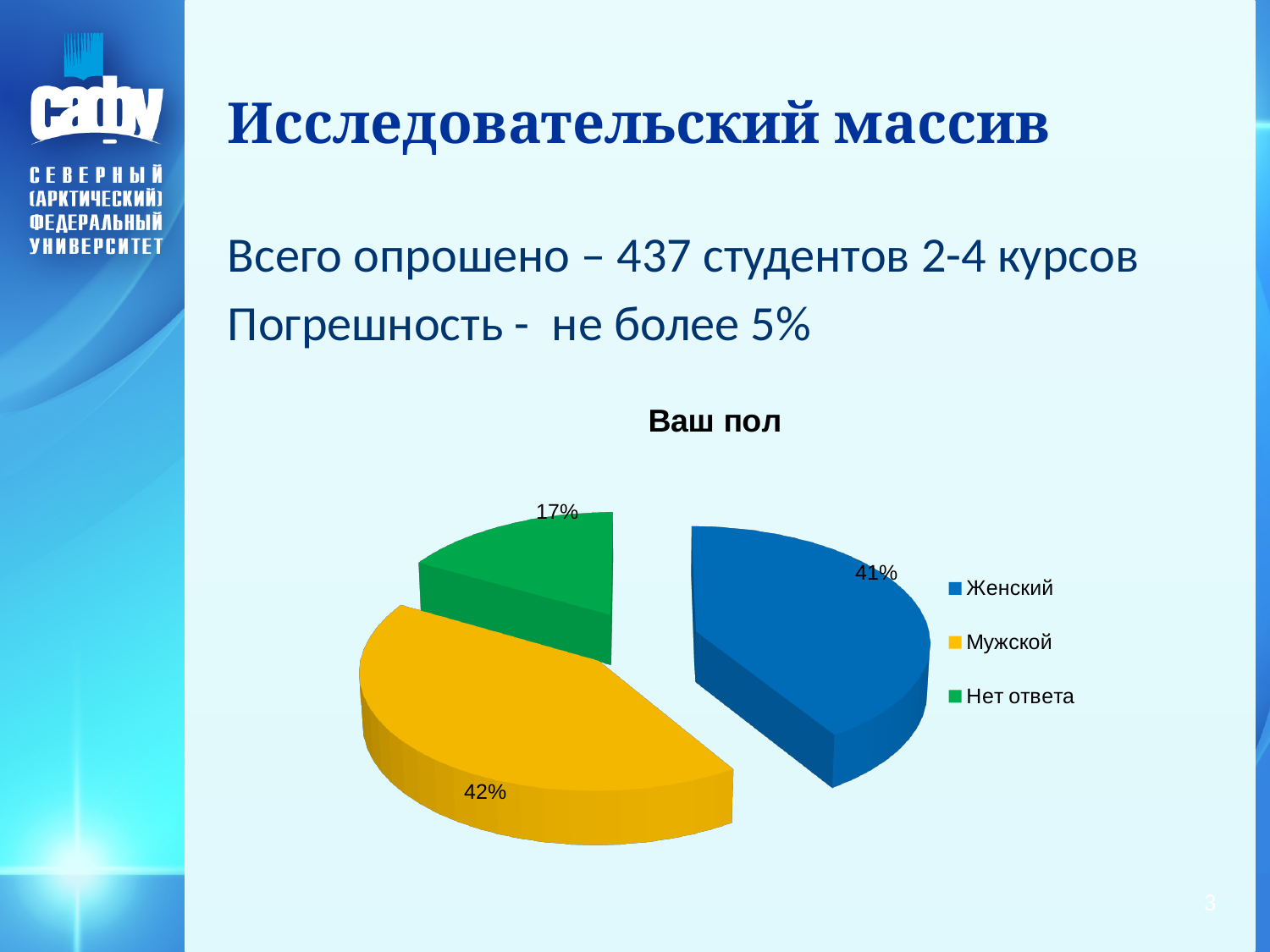
What is the combined share of the "Женский" and "Мужской" slices? 83% What is the difference in percentage points between the "Женский" and "Нет ответа" slices? 24 What percentage of the pie is labelled for "Мужской"? 42% Which category has the largest slice of the pie according to the printed labels? Мужской Which slice is larger: "Мужской" or "Нет ответа"? Мужской What percentage of the pie is labelled for "Нет ответа"? 17% What percentage of the pie is labelled for "Женский"? 41% Which category has the smallest slice of the pie? Нет ответа How many categories does the legend of the pie chart list? 3 What is the title of the chart on the slide? Ваш пол What kind of chart is shown under the title "Ваш пол"? pie chart What colour is the "Нет ответа" slice in the pie chart? green